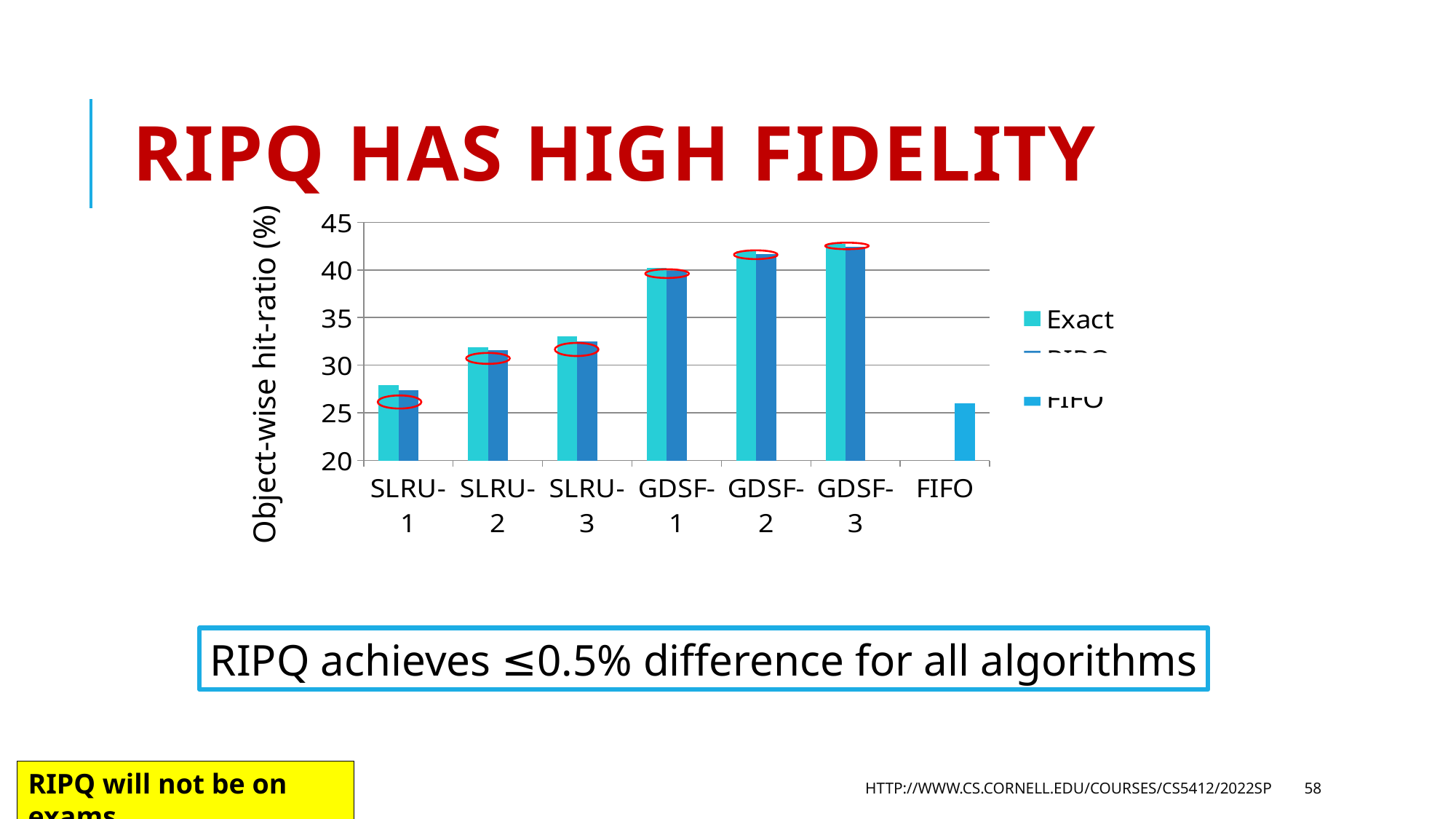
How many series does the chart's legend list? 3 Which category has the highest Exact value? GDSF-3 Which has the larger Exact value, SLRU-3 or GDSF-1? GDSF-1 What is the label of the vertical axis of the chart? Object-wise hit-ratio (%) How many categories are shown along the x axis of the chart? 7 Is the Exact value for GDSF-3 greater or less than 40? greater Is the Exact value for SLRU-3 greater or less than 30? greater Do the Exact values rise or fall from SLRU-1 to SLRU-3? rise What kind of chart is shown on the slide? bar chart Is the value for FIFO greater or less than 25? greater Which category has the lowest Exact value? SLRU-1